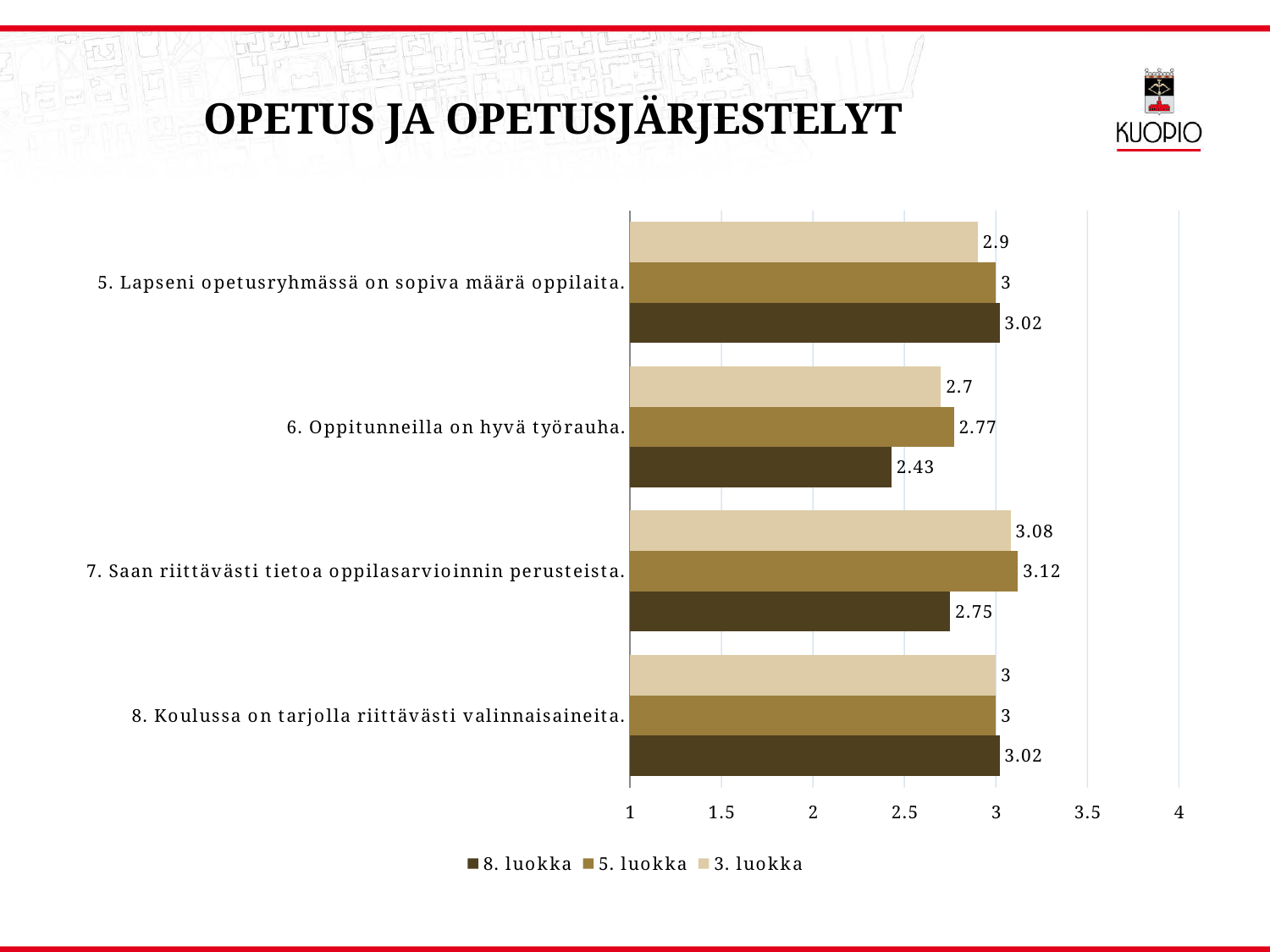
What is the value for 8. luokka for '6. Oppitunneilla on hyvä työrauha.'? 2.43 Which series is shown with the darkest brown bars? 8. luokka What is the value for 3. luokka for '5. Lapseni opetusryhmässä on sopiva määrä oppilaita.'? 2.9 How many series does the legend list? 3 What kind of chart is shown on the slide? bar chart What is the difference between the 5. luokka and 8. luokka values for '7. Saan riittävästi tietoa oppilasarvioinnin perusteista.'? 0.37 What is the value for 8. luokka for '8. Koulussa on tarjolla riittävästi valinnaisaineita.'? 3.02 For '6. Oppitunneilla on hyvä työrauha.', which is larger: the value for 5. luokka or for 8. luokka? 5. luokka How many categories (statements) are shown on the chart? 4 Which statement has the highest value for 5. luokka? 7. Saan riittävästi tietoa oppilasarvioinnin perusteista. What is the value for 5. luokka for '7. Saan riittävästi tietoa oppilasarvioinnin perusteista.'? 3.12 Which statement has the lowest value for 8. luokka? 6. Oppitunneilla on hyvä työrauha.